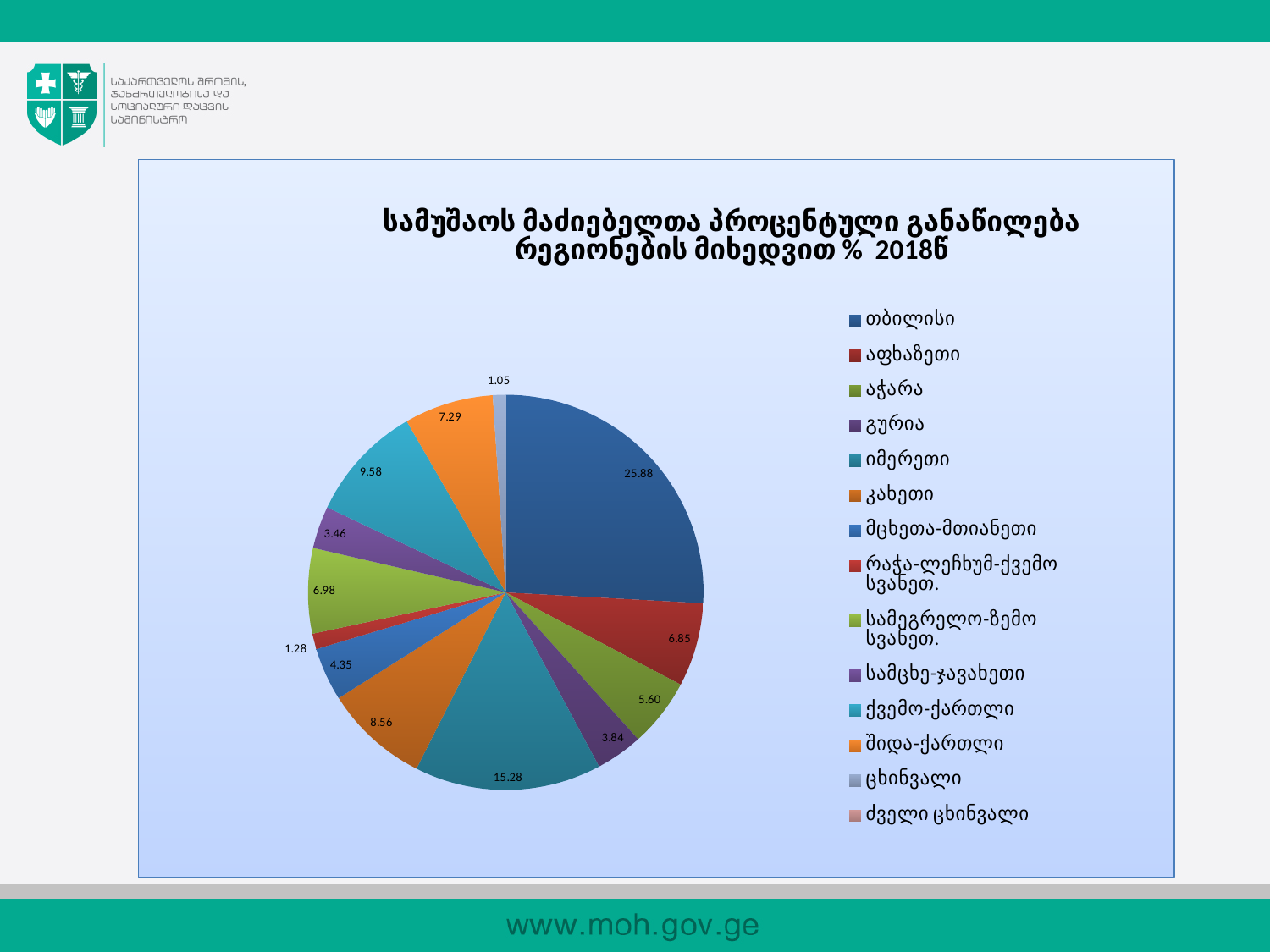
What is the difference between the values for ქვემო-ქართლი and კახეთი? 1.02 What is the value shown for თბილისი in the pie chart? 25.88 What year is given in the chart title? 2018 Which is larger, the value for იმერეთი or the value for ქვემო-ქართლი? იმერეთი What is the value shown for ცხინვალი in the pie chart? 1.05 How many regions are listed in the legend of the pie chart? 14 Which region has the largest slice of the pie chart? თბილისი What is the value shown for კახეთი in the pie chart? 8.56 What kind of chart is shown on the slide? pie chart What is the value shown for იმერეთი in the pie chart? 15.28 What is the value shown for ქვემო-ქართლი in the pie chart? 9.58 What is the difference between the values for თბილისი and იმერეთი? 10.60